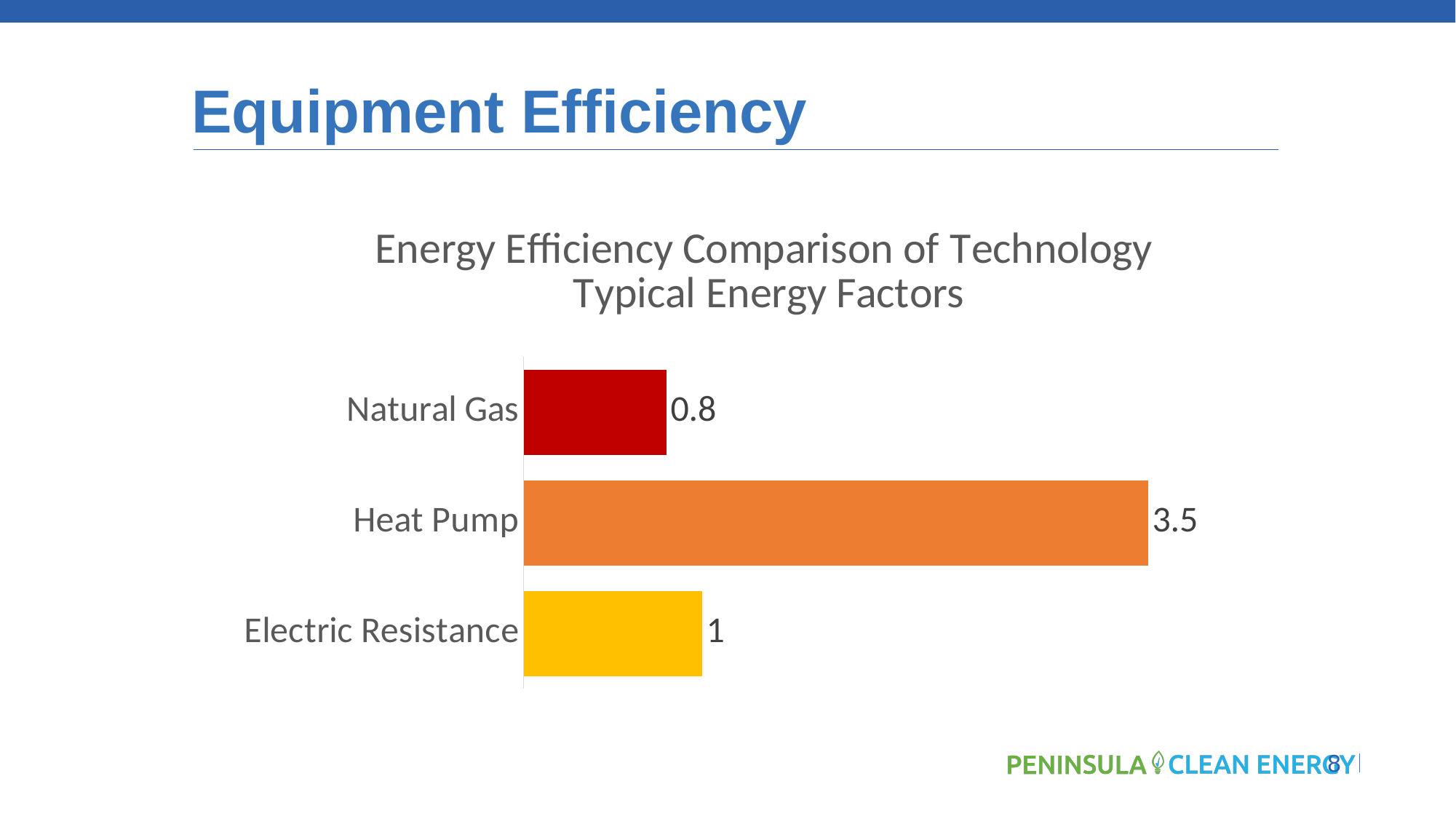
How many technologies are compared in the chart? 3 Which has a larger energy factor, Heat Pump or Electric Resistance? Heat Pump What is the typical energy factor shown for Electric Resistance? 1 Which technology has the highest energy factor? Heat Pump What is the typical energy factor shown for Heat Pump? 3.5 What is the difference between the energy factors of Electric Resistance and Natural Gas? 0.2 What is the difference between the energy factors of Heat Pump and Natural Gas? 2.7 What kind of chart is shown on the slide? Bar chart Which has a larger energy factor, Electric Resistance or Natural Gas? Electric Resistance Which technology has the lowest energy factor? Natural Gas What is the typical energy factor shown for Natural Gas? 0.8 What is the title of the chart? Energy Efficiency Comparison of Technology Typical Energy Factors